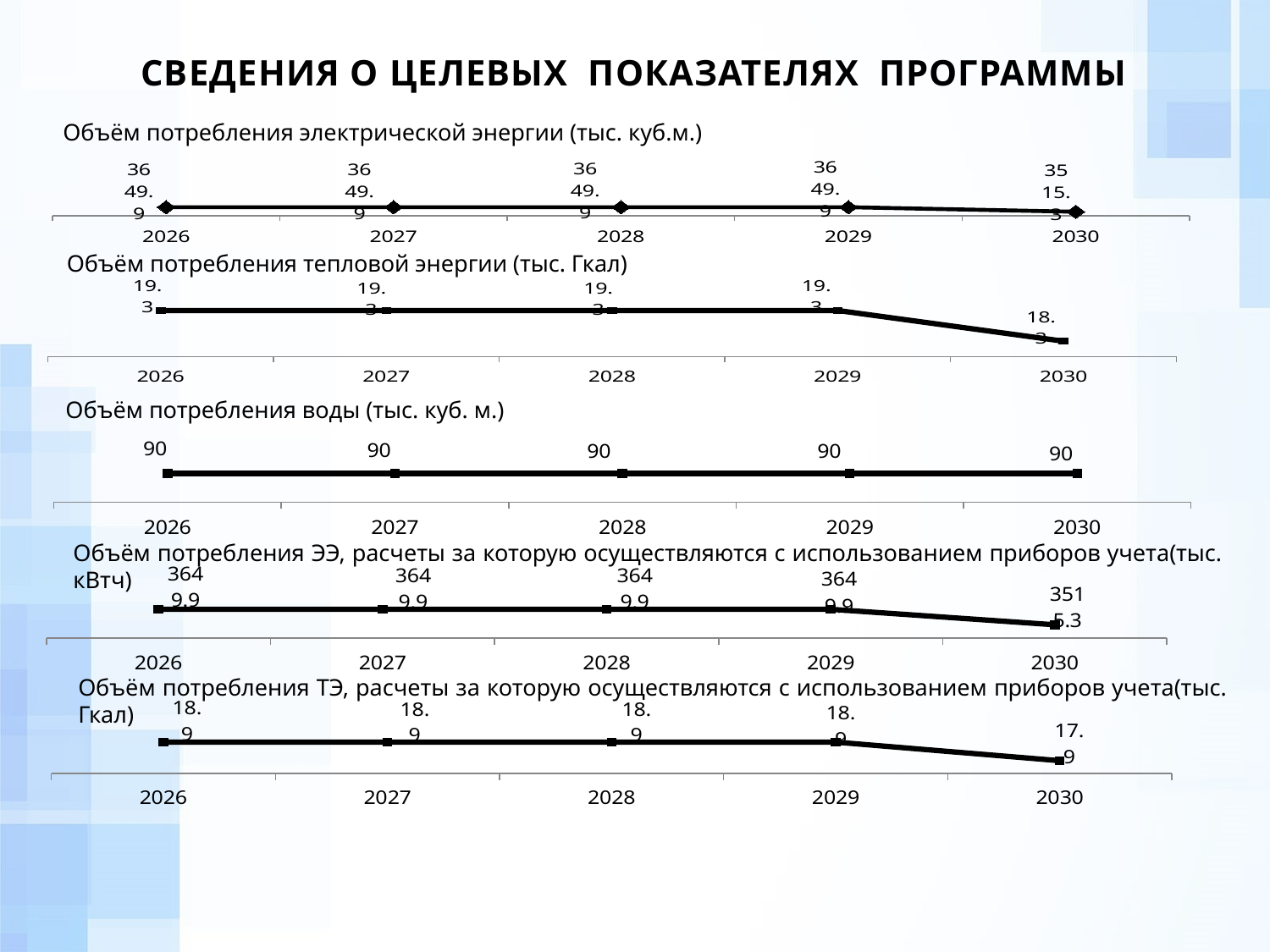
On the chart 'Объём потребления воды (тыс. куб. м.)', how many years are plotted on the x axis? 5 On the chart 'Объём потребления тепловой энергии (тыс. Гкал)', what is the difference between the 2029 and 2030 values? 1 On the chart 'Объём потребления тепловой энергии (тыс. Гкал)', what is the value for 2030? 18.3 What kind of chart is 'Объём потребления тепловой энергии (тыс. Гкал)'? line chart On the chart 'Объём потребления воды (тыс. куб. м.)', what is the value for 2028? 90 How many charts are shown on the slide? 5 On the chart 'Объём потребления электрической энергии (тыс. куб.м.)', which year has the lowest value? 2030 On the chart 'Объём потребления ТЭ, расчеты за которую осуществляются с использованием приборов учета(тыс. Гкал)', what is the value for 2030? 17.9 On the chart 'Объём потребления тепловой энергии (тыс. Гкал)', what is the value for 2026? 19.3 On the chart 'Объём потребления тепловой энергии (тыс. Гкал)', which year has the lowest value? 2030 On the chart 'Объём потребления ТЭ, расчеты за которую осуществляются с использованием приборов учета(тыс. Гкал)', is the value for 2027 larger or smaller than the value for 2030? larger On the chart 'Объём потребления воды (тыс. куб. м.)', do the values rise, fall or stay flat from 2026 to 2030? stay flat